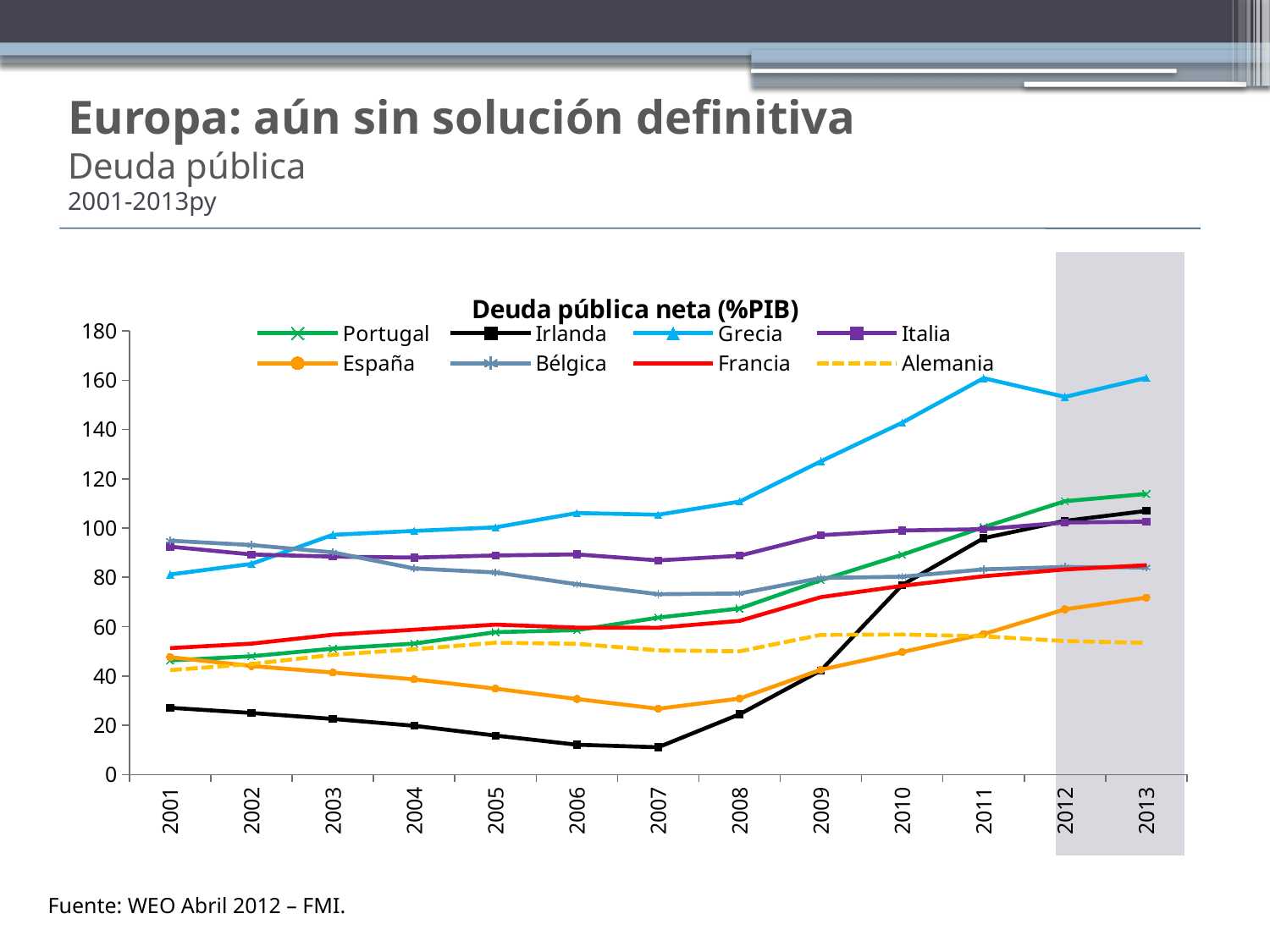
Is the value for Grecia in 2011 greater or less than 140? greater Which is larger in 2013, the value for Portugal or the value for España? Portugal Is the value for Irlanda in 2007 greater or less than 20? less What kind of chart is shown on the slide? line chart Which country has the highest net public debt in 2013? Grecia Which series is drawn with a dashed line? Alemania What is the title of the chart? Deuda pública neta (%PIB) Which country has the lowest net public debt in 2007? Irlanda Which country has the lowest net public debt in 2013? Alemania How many years are shown on the x axis? 13 How many series does the legend list? 8 Does the value for Irlanda rise or fall from 2007 to 2013? rise